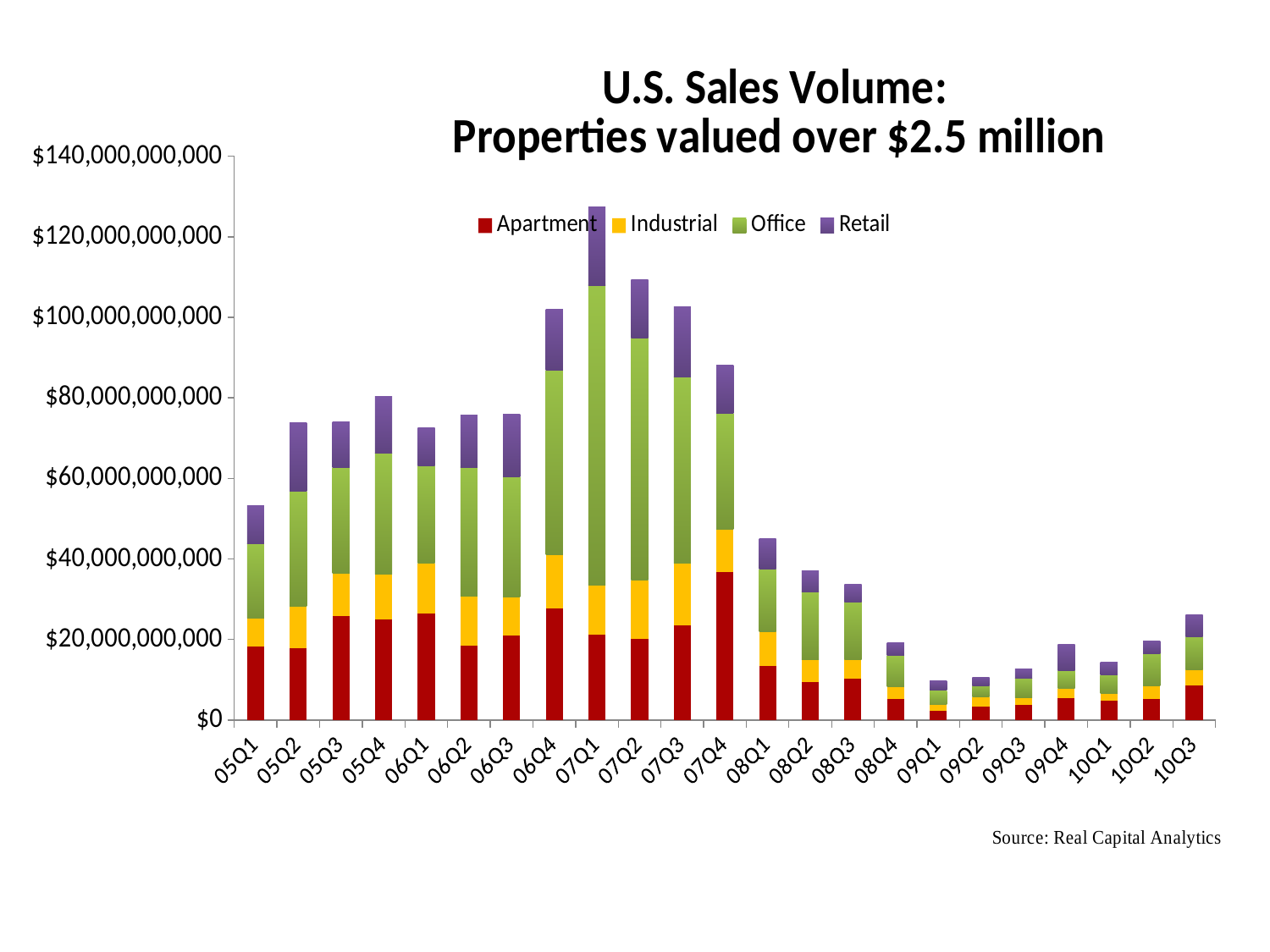
Is the total sales volume for 09Q1 greater or less than $20,000,000,000? less Is the total sales volume for 07Q4 greater or less than $80,000,000,000? greater Is the total sales volume for 07Q1 greater or less than $120,000,000,000? greater Do total sales volumes rise or fall from 07Q1 to 09Q1? fall How many series does the legend list? 4 How many quarters are plotted along the x axis? 23 What kind of chart is shown on the slide? Stacked bar chart Which series is shown in dark red? Apartment Which quarter has the highest total sales volume? 07Q1 Which quarter has the larger total sales volume, 07Q2 or 07Q3? 07Q2 Which quarter has the lowest total sales volume? 09Q1 Which quarter has the larger total sales volume, 10Q2 or 10Q3? 10Q3